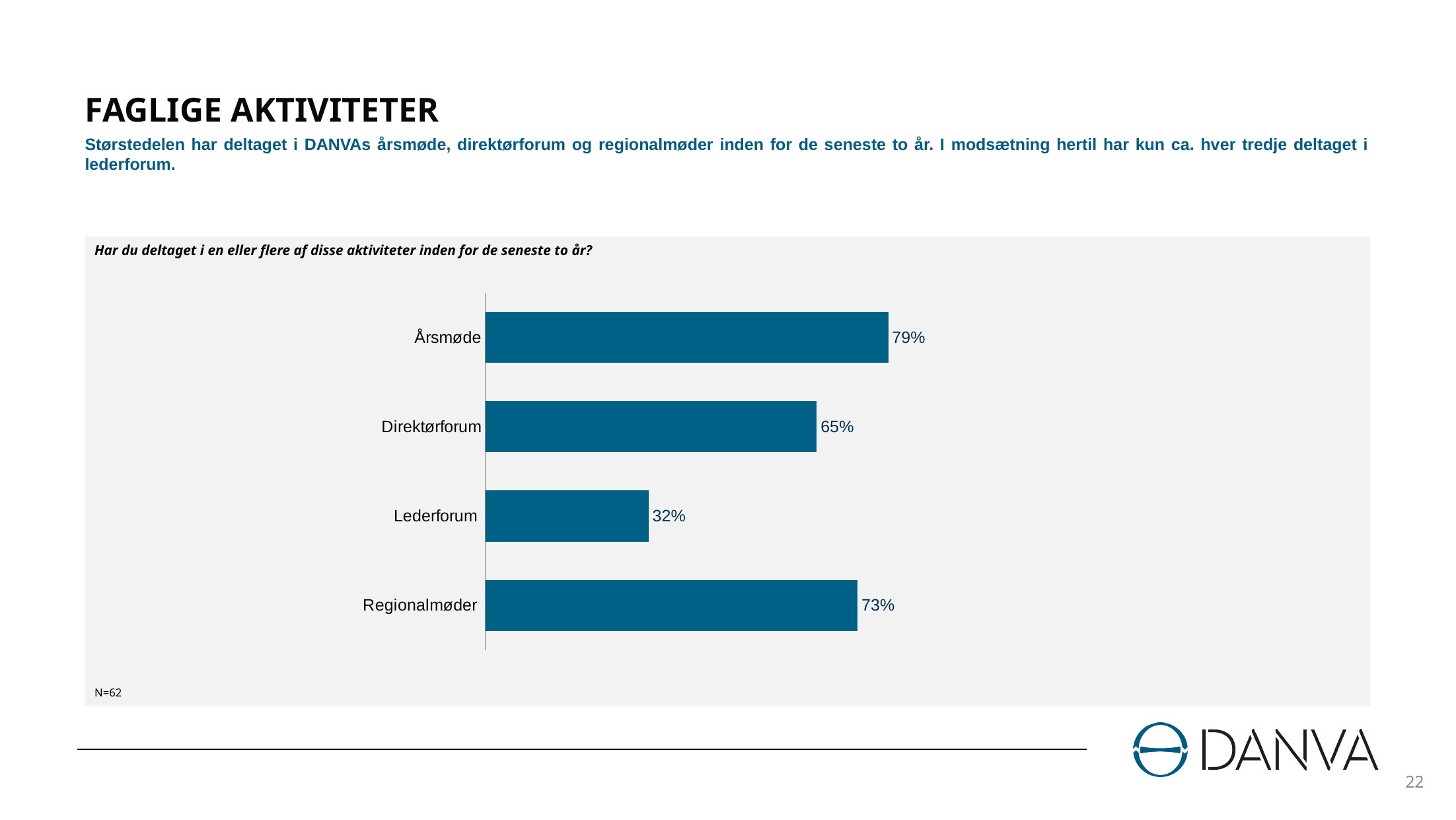
Which activity has the highest share of participation? Årsmøde Which is larger, the value for Regionalmøder or the value for Direktørforum? Regionalmøder How many activities are shown in the chart? 4 What is the difference between the values for Regionalmøder and Direktørforum? 8 percentage points What kind of chart is shown on the slide? Bar chart What is the difference between the values for Årsmøde and Lederforum? 47 percentage points Which activity has the lowest share of participation? Lederforum What is the value for Årsmøde? 79% What is the value for Lederforum? 32% What is the sample size (N) stated below the chart? N=62 What is the value for Regionalmøder? 73% What is the value for Direktørforum? 65%